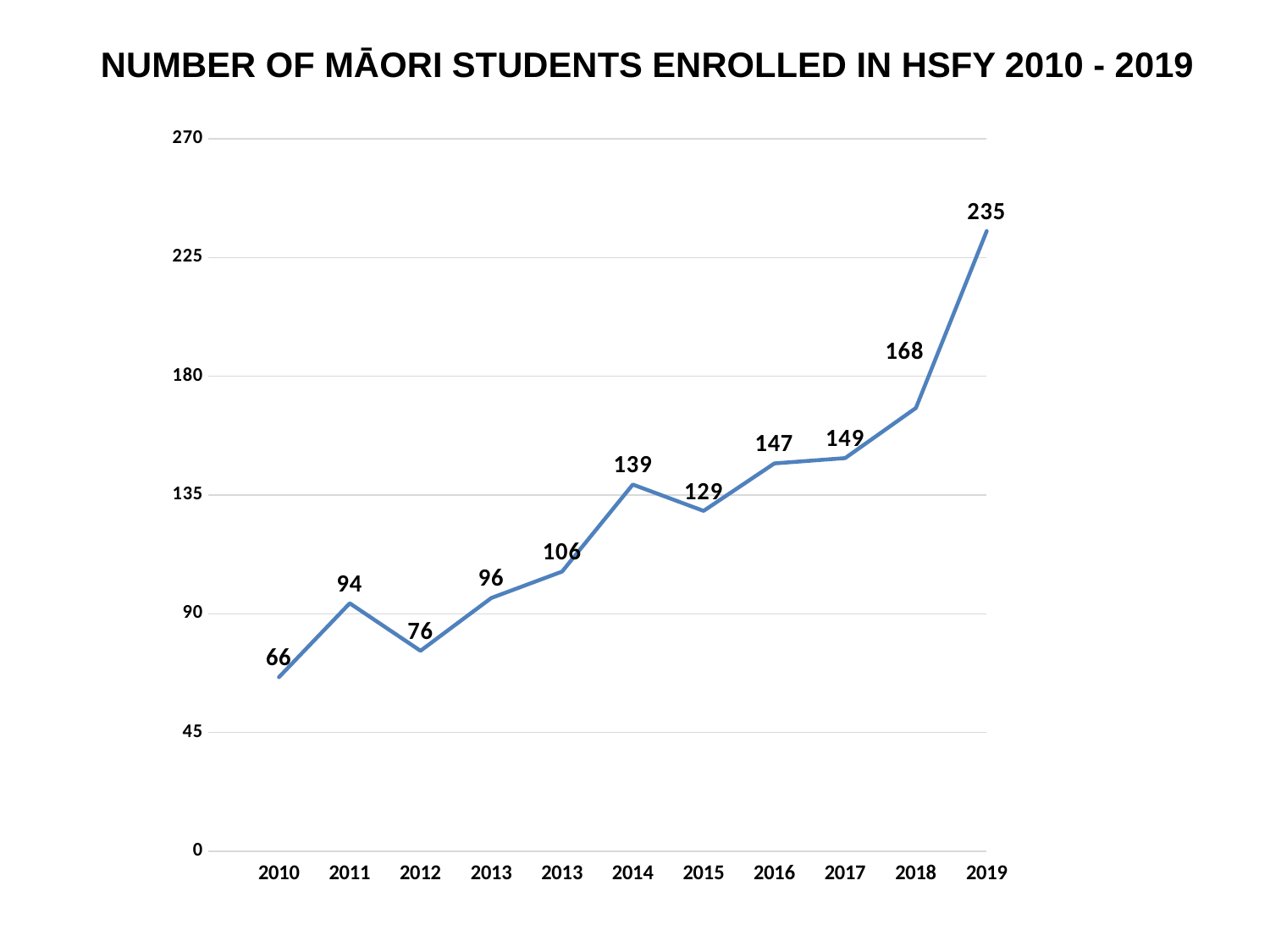
How many data points are plotted on the line chart? 11 What is the number of Māori students enrolled in HSFY in 2018? 168 What is the number of Māori students enrolled in HSFY in 2019? 235 Which year had more Māori students enrolled in HSFY, 2011 or 2012? 2011 What type of chart is shown on the slide? line chart Which year has the lowest number of Māori students enrolled in HSFY? 2010 What is the number of Māori students enrolled in HSFY in 2010? 66 What is the overall trend in the number of Māori students enrolled in HSFY from 2010 to 2019? rising Which year has the highest number of Māori students enrolled in HSFY? 2019 What is the number of Māori students enrolled in HSFY in 2015? 129 What is the difference between the number of Māori students enrolled in 2014 and in 2015? 10 What is the difference between the number of Māori students enrolled in 2019 and in 2018? 67